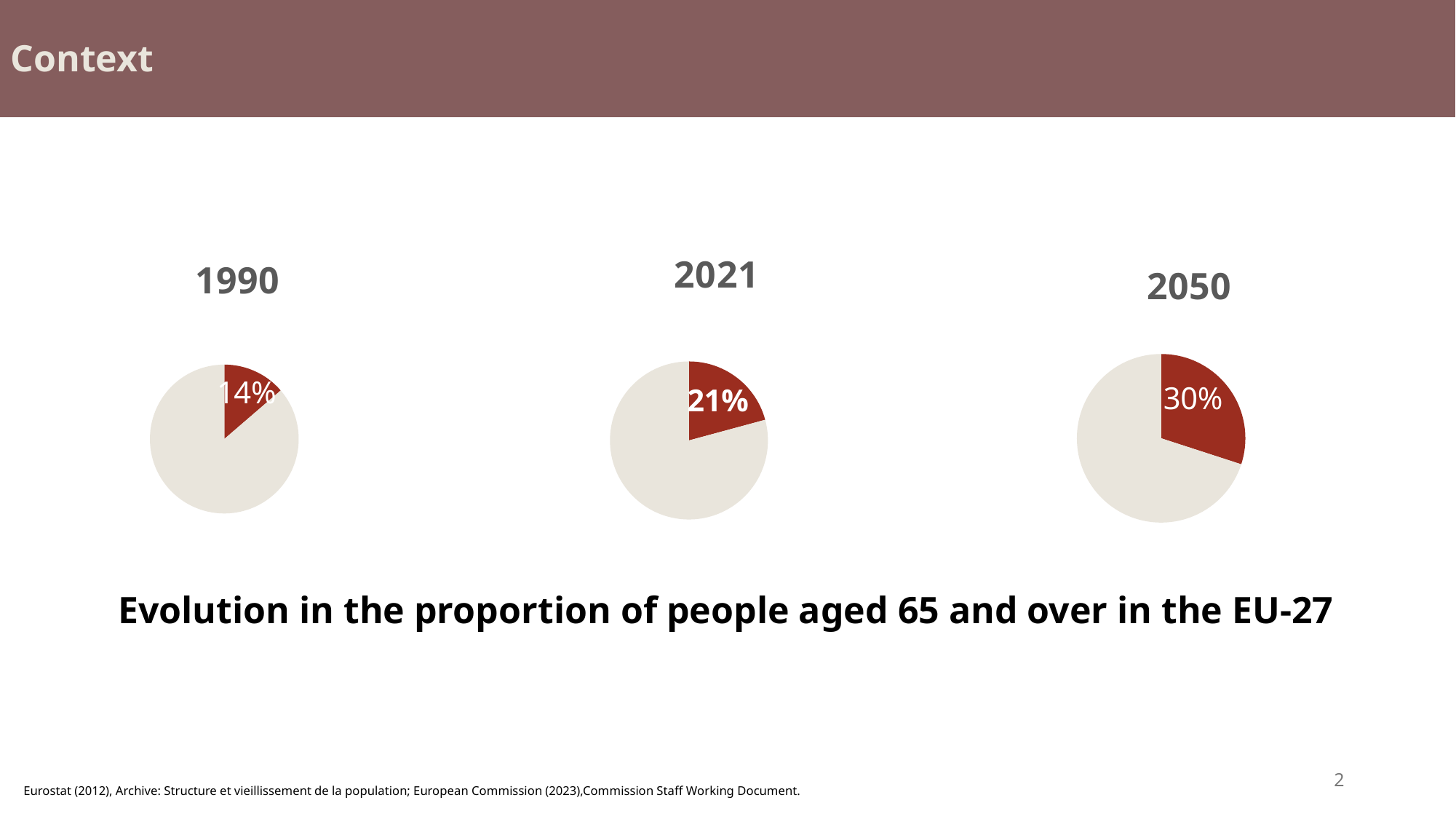
In the 2021 pie chart, what share of people are aged 65 and over? 21% Which is larger: the proportion in the 2021 pie chart or the 2050 pie chart? 2050 What is the difference between the proportion shown in the 2021 pie chart and the 1990 pie chart? 7 percentage points Which year's pie chart shows the lowest proportion of people aged 65 and over? 1990 What kind of charts are shown on the slide? Pie charts Does the proportion of people aged 65 and over rise or fall from 1990 to 2050 across the pie charts? Rise What is the difference between the proportion shown in the 2050 pie chart and the 1990 pie chart? 16 percentage points In the 1990 pie chart, what share of people are aged 65 and over? 14% How many pie charts are shown on the slide? 3 In the 2050 pie chart, what share of people are aged 65 and over? 30% What is the caption describing the pie charts on the slide? Evolution in the proportion of people aged 65 and over in the EU-27 Which year's pie chart shows the highest proportion of people aged 65 and over? 2050